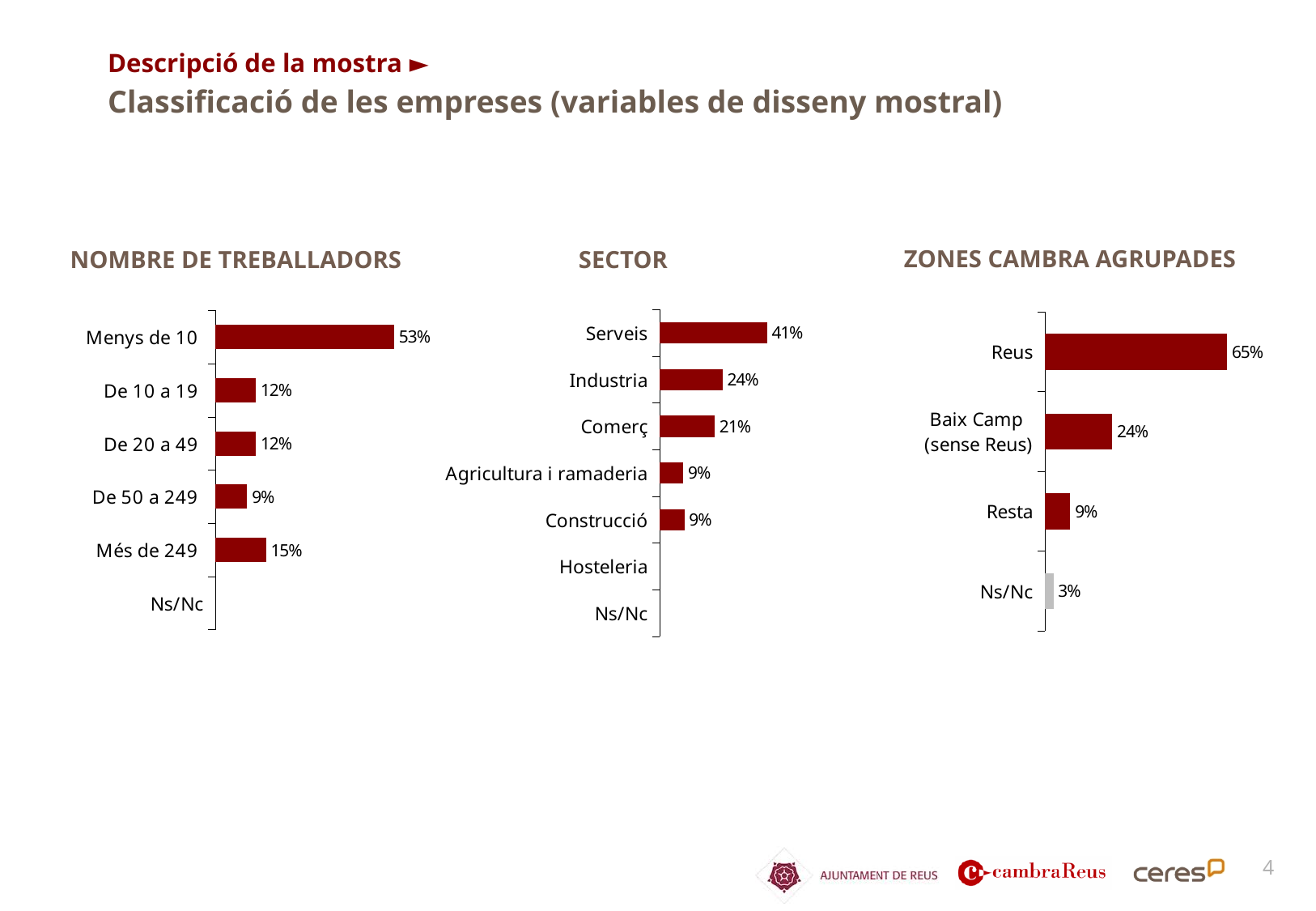
In the NOMBRE DE TREBALLADORS chart, which category has the highest value? Menys de 10 In the SECTOR chart, how many categories are listed on the axis? 7 In the ZONES CAMBRA AGRUPADES chart, what is the difference between Reus and Baix Camp (sense Reus)? 41% In the SECTOR chart, what is the value for Industria? 24% In the NOMBRE DE TREBALLADORS chart, what is the value for Menys de 10? 53% In the NOMBRE DE TREBALLADORS chart, what is the difference between Més de 249 and De 50 a 249? 6% How many charts are shown on the slide? 3 In the ZONES CAMBRA AGRUPADES chart, what is the value for Reus? 65% In the SECTOR chart, which is larger, Comerç or Industria? Industria In the ZONES CAMBRA AGRUPADES chart, which category has the lowest value? Ns/Nc In the SECTOR chart, which category has the highest value? Serveis What kind of chart is the ZONES CAMBRA AGRUPADES chart? Bar chart